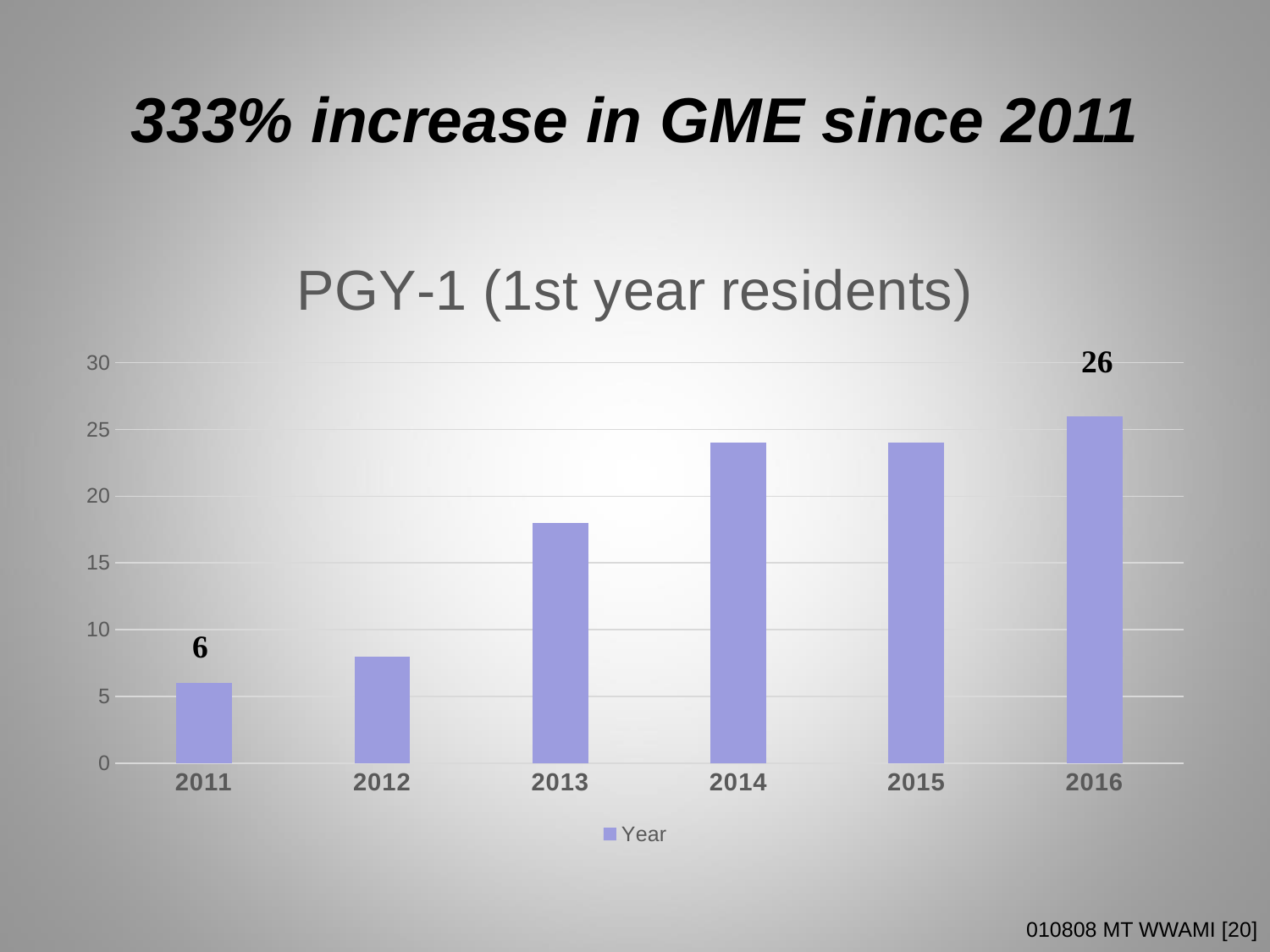
Which year has the lowest value in the PGY-1 (1st year residents) chart? 2011 What kind of chart is used to show the PGY-1 (1st year residents) data? Bar chart Is the value for 2013 in the PGY-1 chart greater or less than 15? greater How many years are shown on the x axis of the PGY-1 (1st year residents) chart? 6 Which year has the highest value in the PGY-1 (1st year residents) chart? 2016 What is the value for 2016 in the PGY-1 (1st year residents) chart? 26 Do the values in the PGY-1 chart generally rise or fall from 2011 to 2016? Rise What is the value for 2011 in the PGY-1 (1st year residents) chart? 6 Which is larger in the PGY-1 chart, the value for 2013 or the value for 2012? 2013 Is the value for 2014 in the PGY-1 chart greater or less than 20? greater Is the value for 2012 in the PGY-1 chart greater or less than 10? less What is the difference between the 2016 and 2011 values in the PGY-1 chart? 20